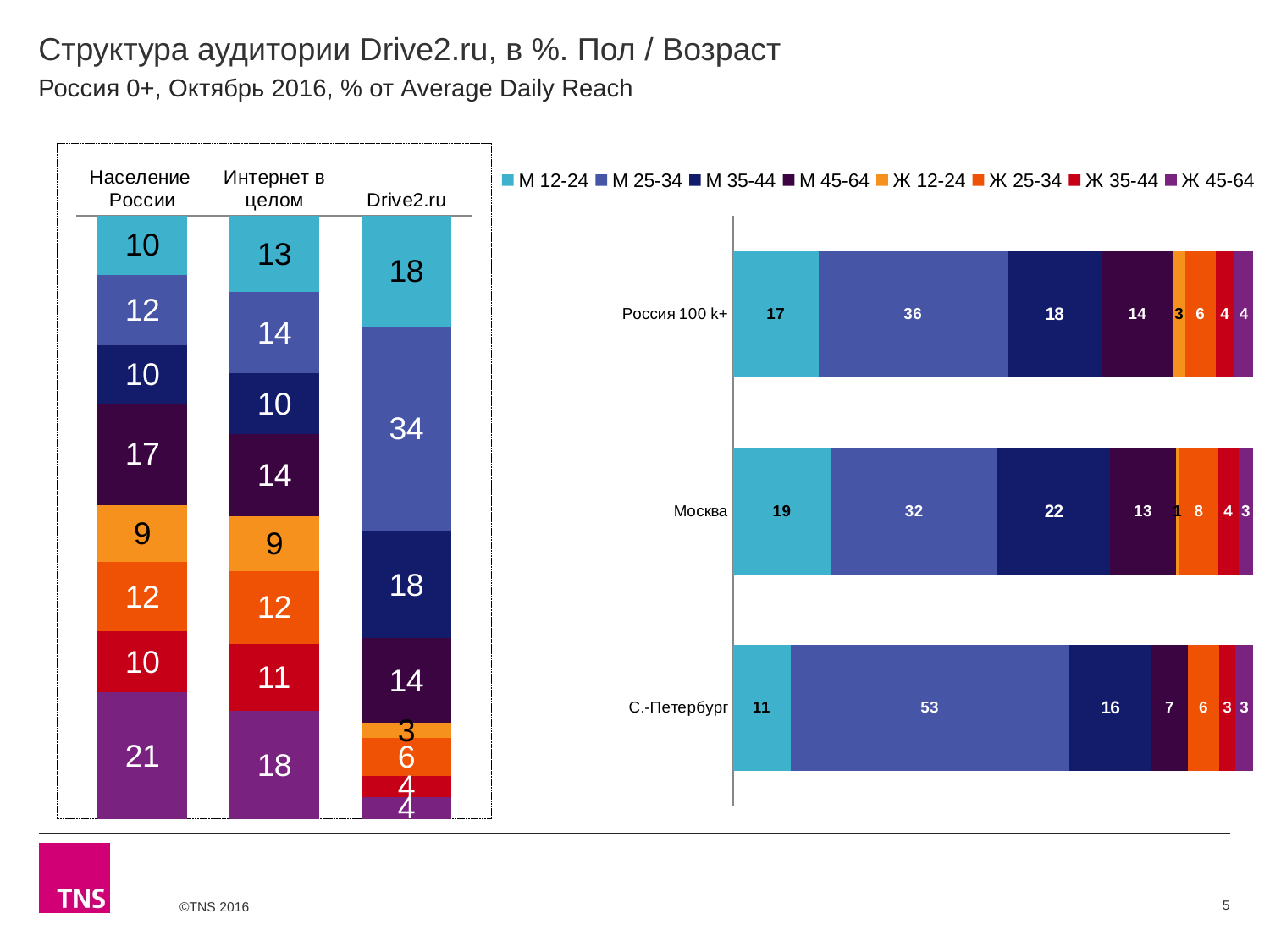
In the left chart, what is the value of the Ж 45-64 segment for Население России? 21 What kind of chart is the right chart? Stacked bar chart In the left chart, which bar has the smallest Ж 45-64 segment? Drive2.ru In the right chart, what is the value of the М 25-34 segment for С.-Петербург? 53 How many bars are shown in the right chart? 3 In the left chart, what is the value of the М 25-34 segment for Drive2.ru? 34 How many series does the legend list? 8 In the left chart, what is the difference between the М 25-34 values for Drive2.ru and Интернет в целом? 20 In the right chart, what is the value of the М 35-44 segment for Москва? 22 In the right chart, is the М 12-24 value larger for Москва or for С.-Петербург? Москва In the right chart, which city or region has the largest М 25-34 segment? С.-Петербург In the right chart, what is the total of the М 12-24 and М 25-34 segments for Россия 100 k+? 53